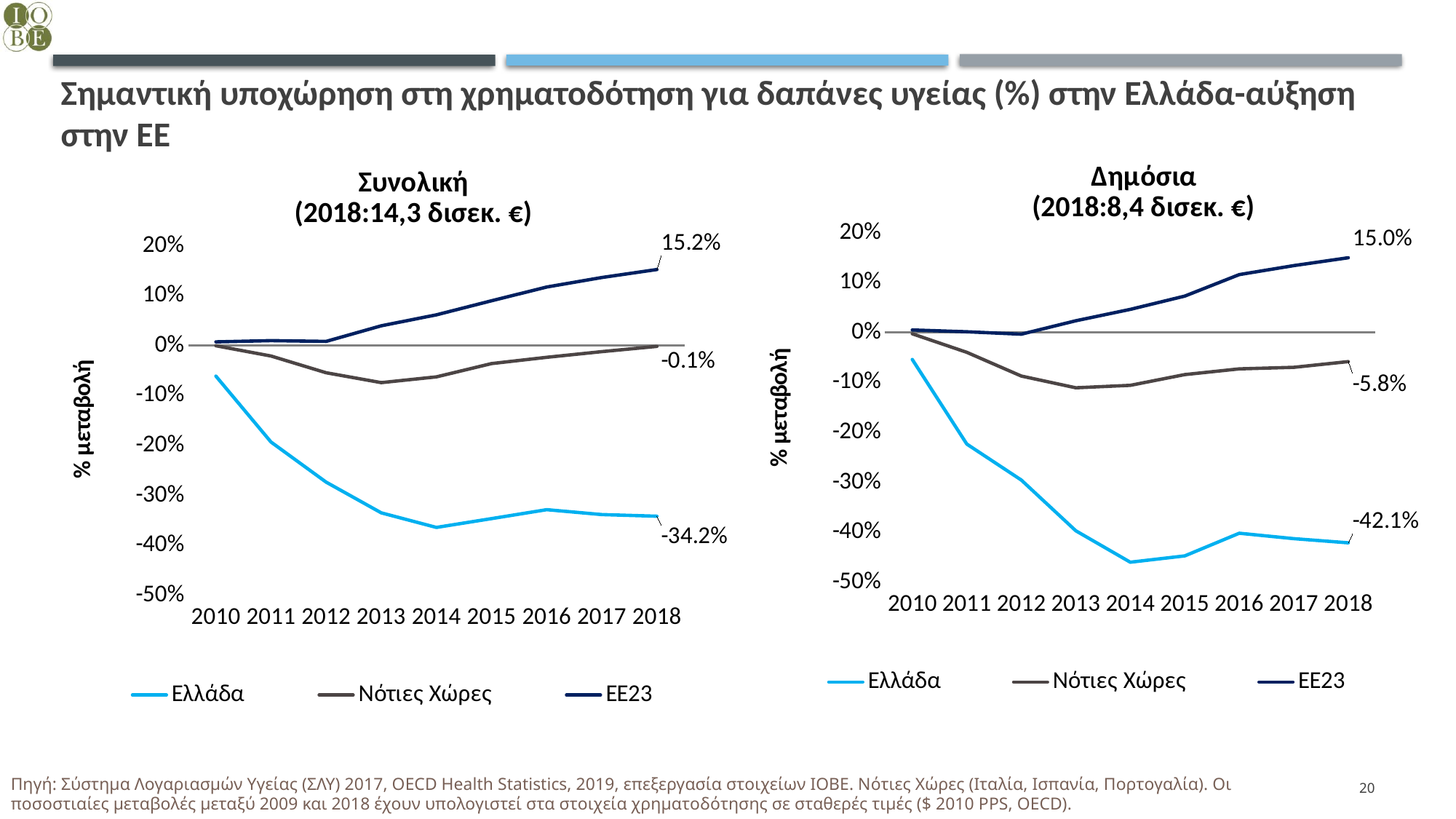
In the right chart (Δημόσια), is the value for Ελλάδα in 2014 greater or less than -40%? less In the left chart (Συνολική), what is the value for ΕΕ23 in 2018? 15.2% What kind of chart is the left chart (Συνολική)? line chart In the right chart (Δημόσια), what is the value for Ελλάδα in 2018? -42.1% In the left chart (Συνολική), what is the value for Ελλάδα in 2018? -34.2% How many years are shown on the x axis of the left chart (Συνολική)? 9 In the left chart (Συνολική), which series has the lowest value in 2018? Ελλάδα In the right chart (Δημόσια), what is the value for Νότιες Χώρες in 2018? -5.8% In the left chart (Συνολική), is the 2018 value for Νότιες Χώρες larger or smaller than the 2018 value for Ελλάδα? larger In the right chart (Δημόσια), what is the difference between the 2018 values for ΕΕ23 and Ελλάδα? 57.1 percentage points How many series does the legend of the right chart (Δημόσια) list? 3 In the right chart (Δημόσια), which series has the highest value in 2018? ΕΕ23